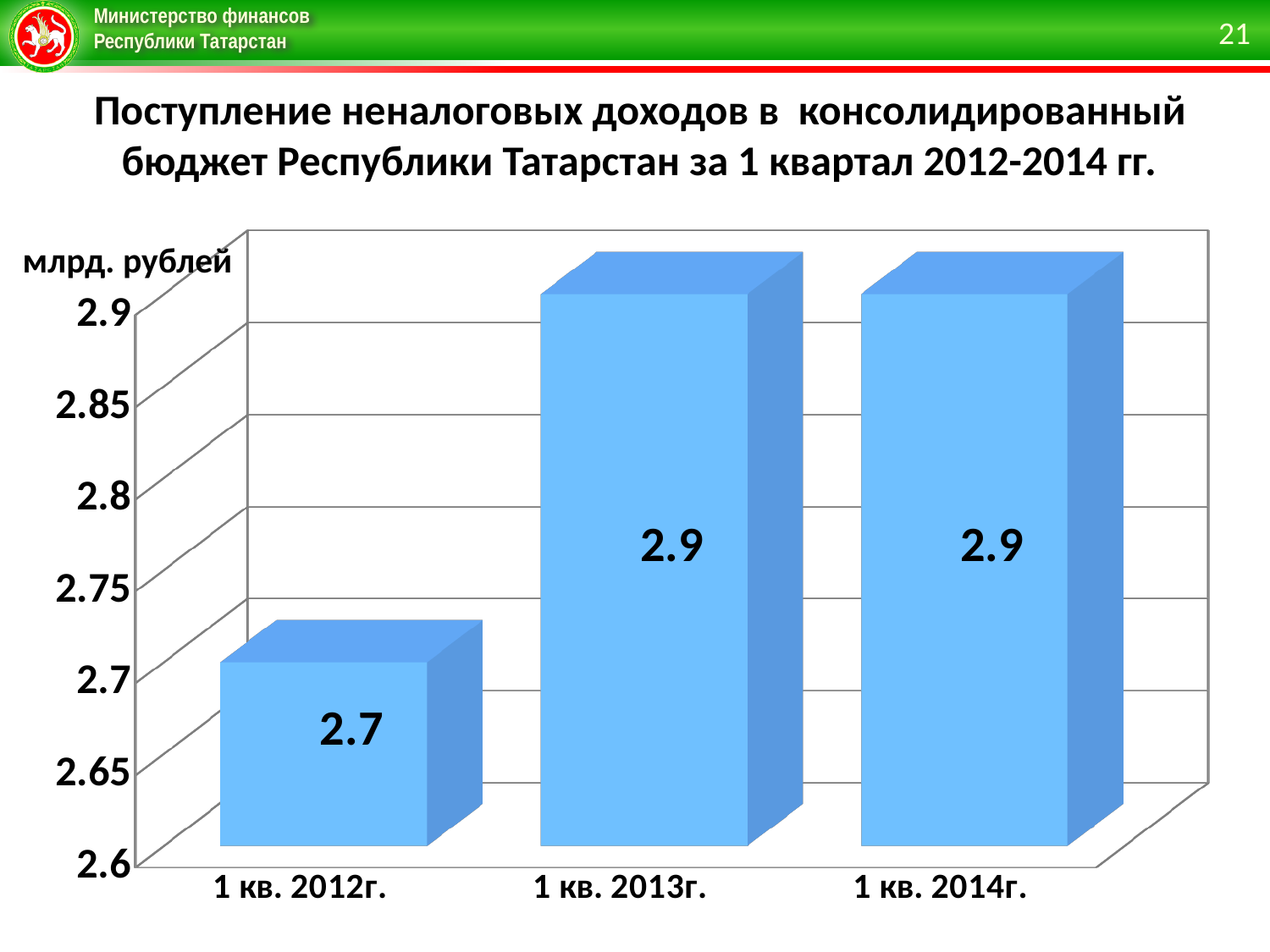
What is the value for 1 кв. 2013г.? 2.9 Is the value for 1 кв. 2012г. greater or less than 2.8? less Which is larger, the value for 1 кв. 2012г. or the value for 1 кв. 2014г.? 1 кв. 2014г. Which category has the lowest value? 1 кв. 2012г. What is the value for 1 кв. 2014г.? 2.9 How many categories are shown on the x axis? 3 What is the value for 1 кв. 2012г.? 2.7 What kind of chart is shown on the slide? bar chart Does the value rise or fall from 1 кв. 2012г. to 1 кв. 2013г.? rise What is the difference between the values for 1 кв. 2013г. and 1 кв. 2012г.? 0.2 What is the title of the chart? Поступление неналоговых доходов в консолидированный бюджет Республики Татарстан за 1 квартал 2012-2014 гг. What unit is shown for the values on the chart? млрд. рублей